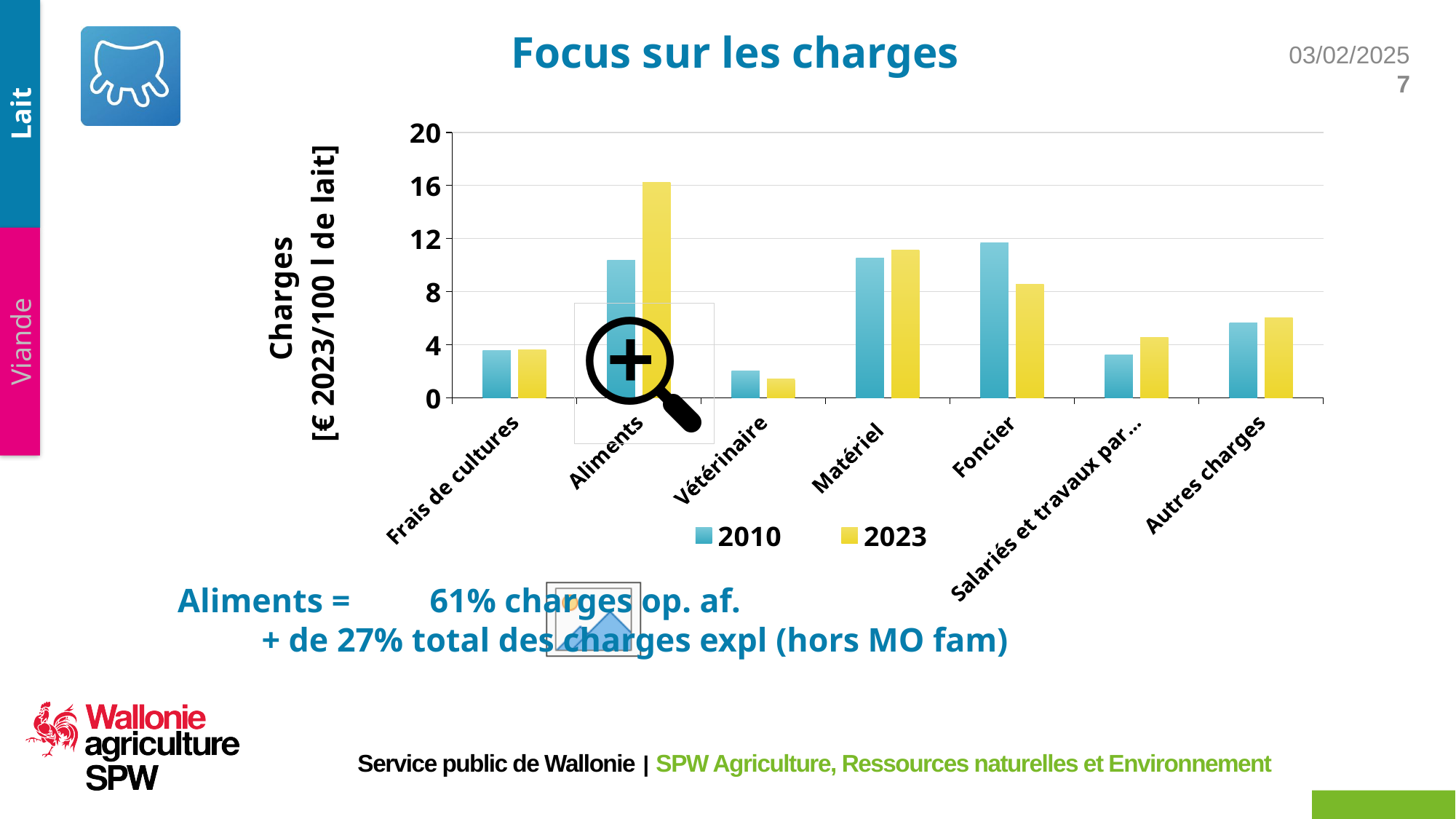
How many series does the legend list? 2 Which category has the highest value for 2023? Aliments What kind of chart is shown on the slide? bar chart Which category has the highest value for 2010? Foncier For Foncier, which year has the larger value, 2010 or 2023? 2010 Which colour represents the 2023 series in the legend? yellow Is the 2023 value for Foncier greater or less than 12? less Which category has the lowest value for 2023? Vétérinaire For Aliments, which year has the larger value, 2010 or 2023? 2023 Is the 2023 value for Aliments greater or less than 12? greater How many categories are shown on the x axis? 7 Is the 2010 value for Foncier greater or less than 8? greater